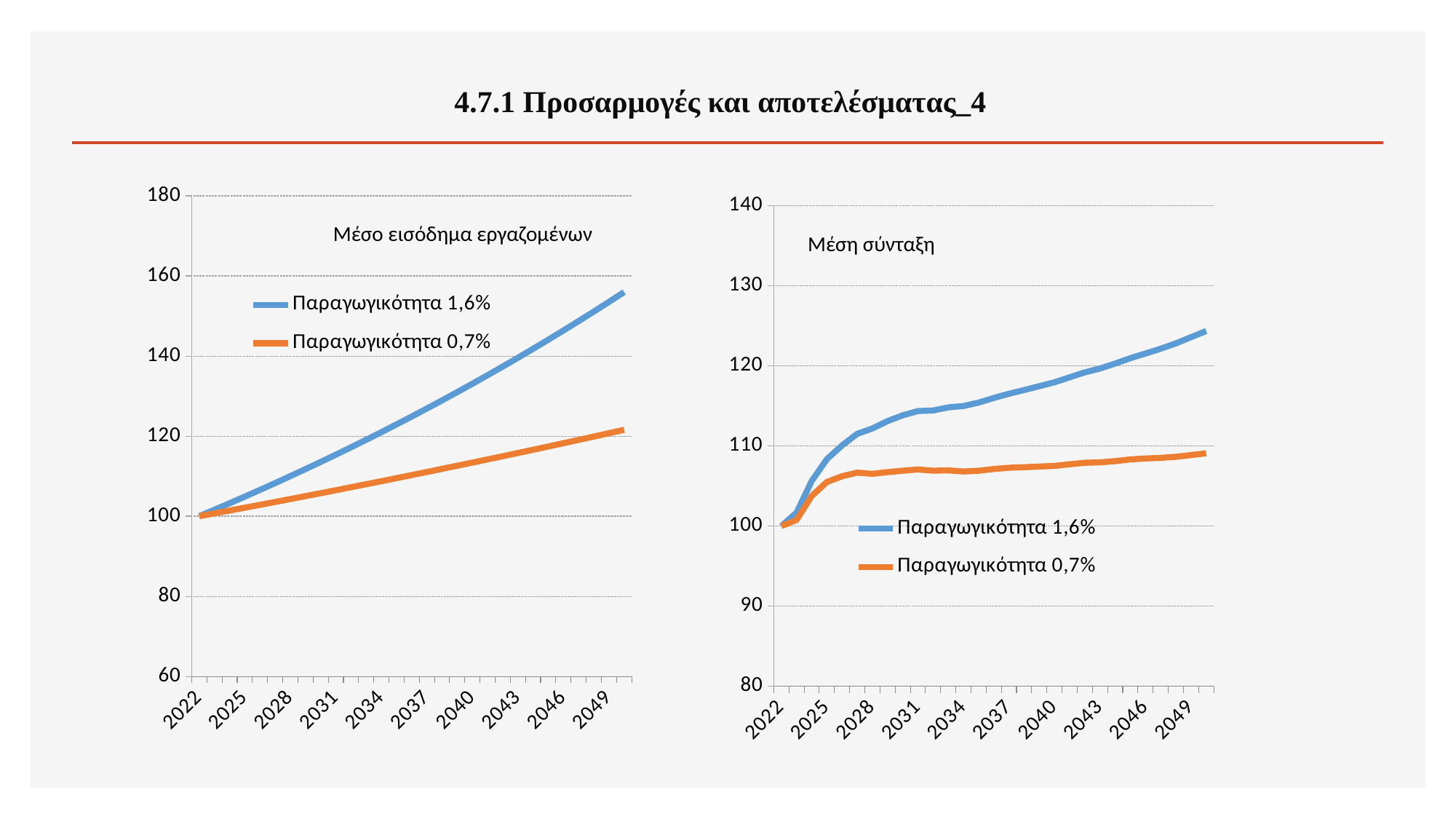
In the left chart "Μέσο εισόδημα εργαζομένων", what is the value of both series in 2022? 100 In the left chart "Μέσο εισόδημα εργαζομένων", is the value of "Παραγωγικότητα 0,7%" at the end of the series greater or less than 140? less What kind of chart is the left chart titled "Μέσο εισόδημα εργαζομένων"? line chart What is the title of the right chart on the slide? Μέση σύνταξη In the right chart "Μέση σύνταξη", is the value of "Παραγωγικότητα 1,6%" at the end of the series greater or less than 120? greater In the left chart "Μέσο εισόδημα εργαζομένων", is the value of "Παραγωγικότητα 1,6%" at the end of the series greater or less than 140? greater In the right chart "Μέση σύνταξη", does the "Παραγωγικότητα 0,7%" line rise or fall between 2022 and 2028? rise How many series does the legend of the right chart "Μέση σύνταξη" list? 2 In the left chart "Μέσο εισόδημα εργαζομένων", does the "Παραγωγικότητα 1,6%" line rise or fall from 2022 to 2049? rise What colour is the "Παραγωγικότητα 0,7%" line in the left chart "Μέσο εισόδημα εργαζομένων"? orange In the right chart "Μέση σύνταξη", which series is higher in 2049: "Παραγωγικότητα 1,6%" or "Παραγωγικότητα 0,7%"? Παραγωγικότητα 1,6%